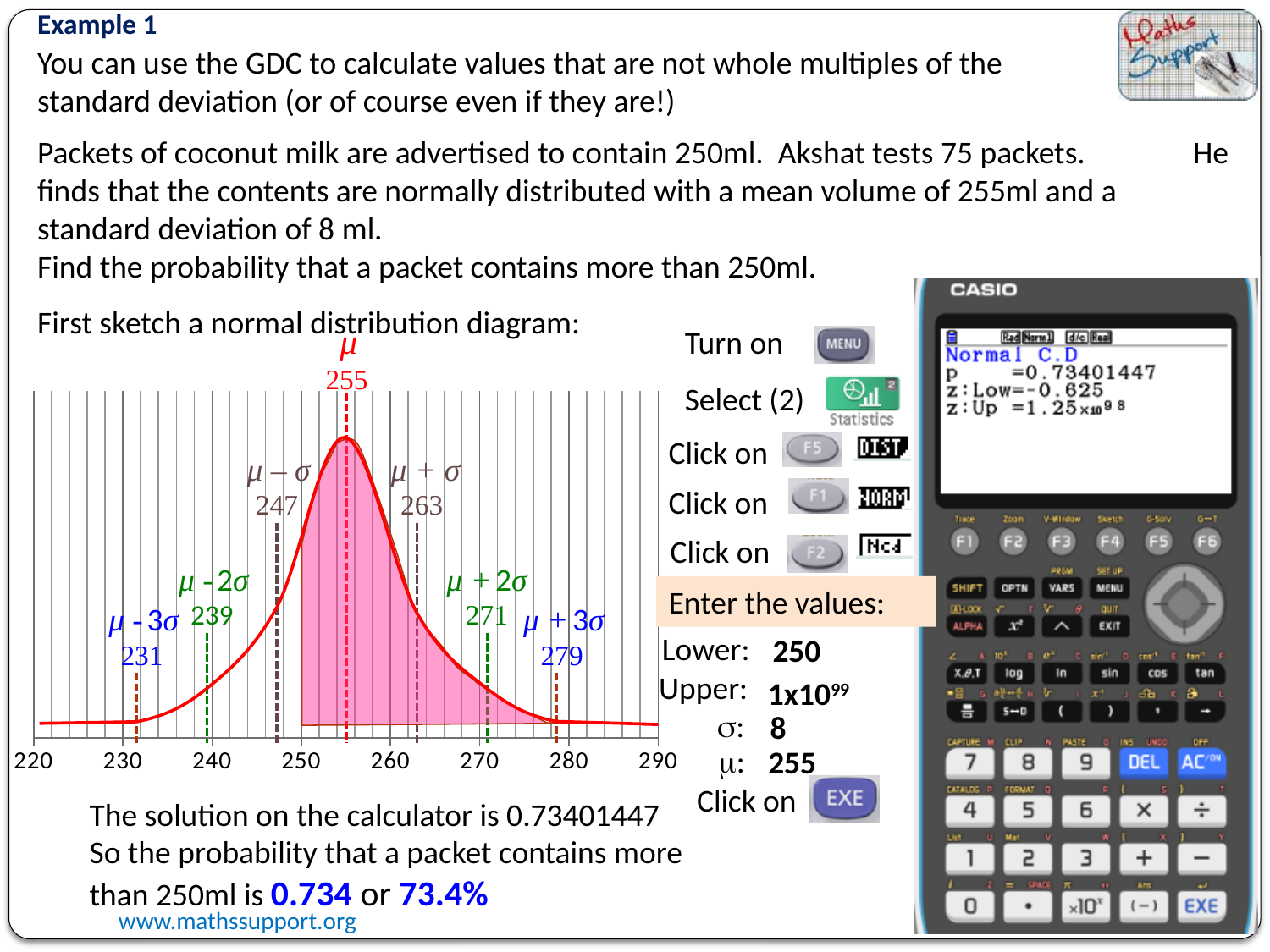
On the normal distribution diagram, what value is labelled at the mean μ? 255 On the normal distribution diagram, what value is labelled at μ − 2σ? 239 On the normal distribution diagram, which is larger: the value labelled at μ + 2σ or the value labelled at μ − 3σ? μ + 2σ (271) How many dashed vertical lines marking μ and multiples of σ are drawn on the normal distribution diagram? 7 On the normal distribution diagram, what is the difference between the values labelled at μ + 3σ and μ − 3σ? 48 On the normal distribution diagram, at what x value does the pink shaded region begin? 250 On the normal distribution diagram, what value is labelled at μ + σ? 263 On the normal distribution diagram, does the curve rise or fall as x increases from 255 to 290? Fall What kind of chart is shown on the slide? A normal distribution curve (line chart) On the normal distribution diagram, what value is labelled at μ − σ? 247 On the normal distribution diagram, what value is labelled at μ + 3σ? 279 On the normal distribution diagram, what is the difference between the values labelled at μ + σ and μ − σ? 16